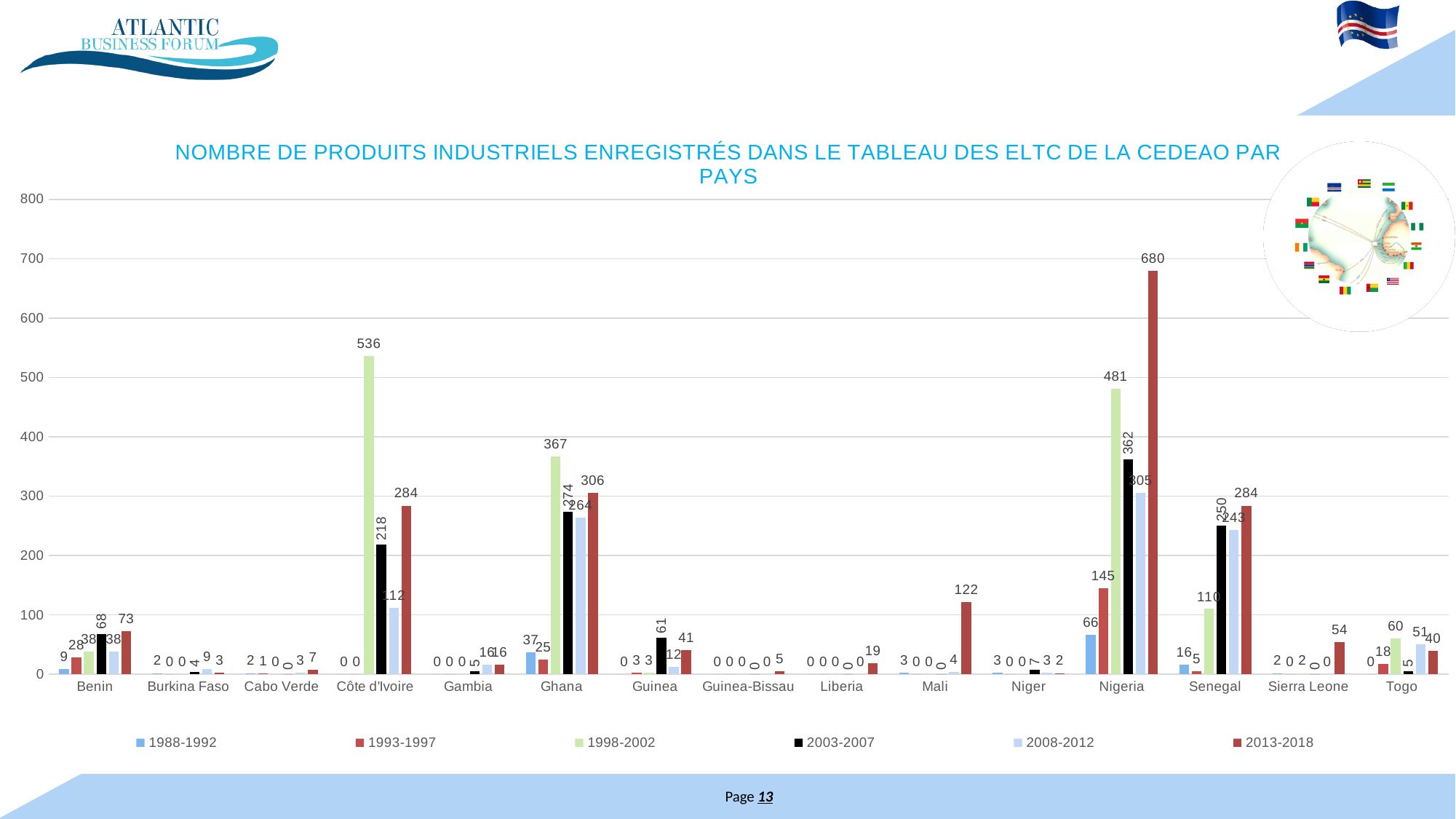
How many countries are shown on the x axis? 15 Which is larger in the 2013-2018 series: Ghana or Senegal? Ghana What is the value for Nigeria in the 2013-2018 series? 680 What is the value for Mali in the 2013-2018 series? 122 How many series does the legend list? 6 What is the difference between Senegal's 2013-2018 value and its 2008-2012 value? 41 What is the difference between Nigeria's 2013-2018 value and Côte d'Ivoire's 1998-2002 value? 144 What is the value for Côte d'Ivoire in the 1998-2002 series? 536 Which country has the highest value in the 1998-2002 series? Côte d'Ivoire What is the value for Ghana in the 2003-2007 series? 274 Which country has the highest value in the 2013-2018 series? Nigeria What kind of chart is shown on the slide? Bar chart